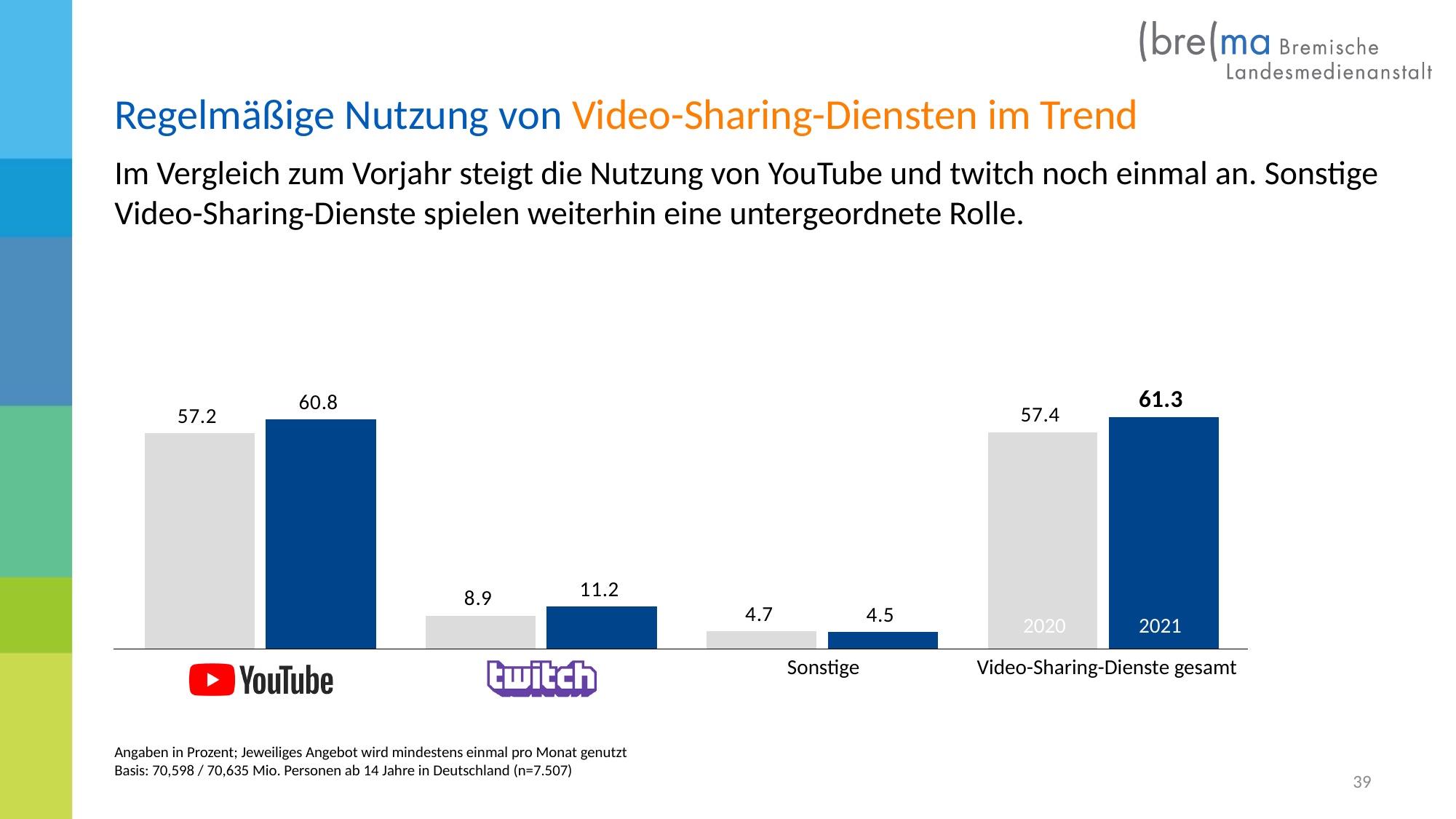
How many categories are shown on the x axis? 4 What is the 2020 value for Sonstige? 4.7 What is the 2021 value for Video-Sharing-Dienste gesamt? 61.3 Which category has the lowest 2020 value? Sonstige Is the 2021 value for Sonstige larger or smaller than its 2020 value? smaller Which category has the highest 2021 value? Video-Sharing-Dienste gesamt What is the 2021 value for YouTube? 60.8 By how much did the YouTube value increase from 2020 to 2021? 3.6 What is the difference between the 2021 and 2020 values for twitch? 2.3 What type of chart is shown on the slide? bar chart How many series (years) are shown in the chart? 2 What is the 2020 value for twitch? 8.9